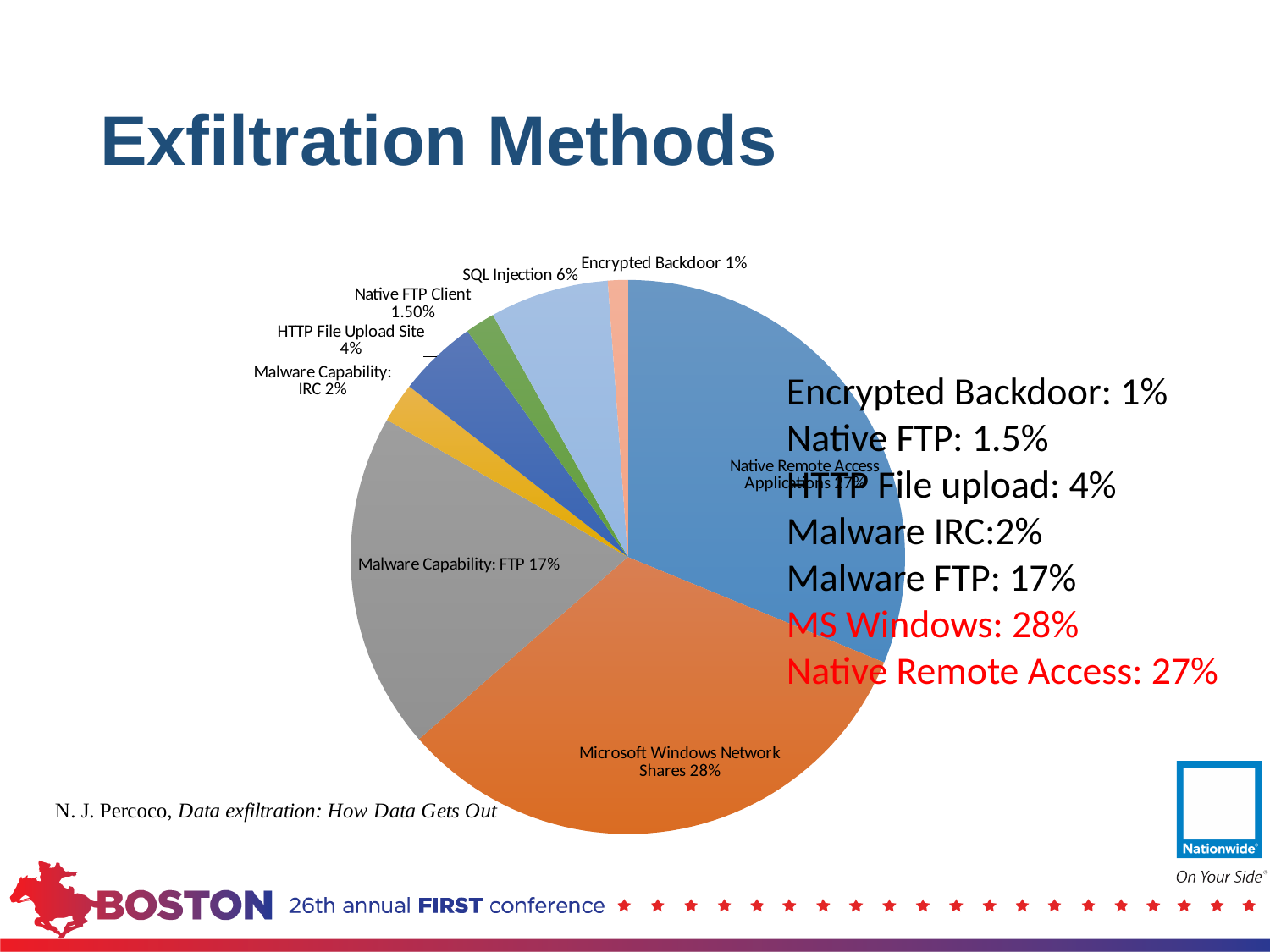
Which exfiltration method has the largest slice of the pie? Microsoft Windows Network Shares What is the difference between the Microsoft Windows Network Shares share and the Malware Capability: FTP share? 11% What is the value shown for Native FTP Client? 1.50% What is the value shown for Encrypted Backdoor? 1% What is the value shown for SQL Injection? 6% What kind of chart is shown on the slide? pie chart Which exfiltration method has the smallest slice of the pie? Encrypted Backdoor What is the value shown for HTTP File Upload Site? 4% What is the value shown for Malware Capability: FTP? 17% Which is larger, SQL Injection or HTTP File Upload Site? SQL Injection What share of the pie does Microsoft Windows Network Shares have? 28% How many slices does the pie chart have? 8